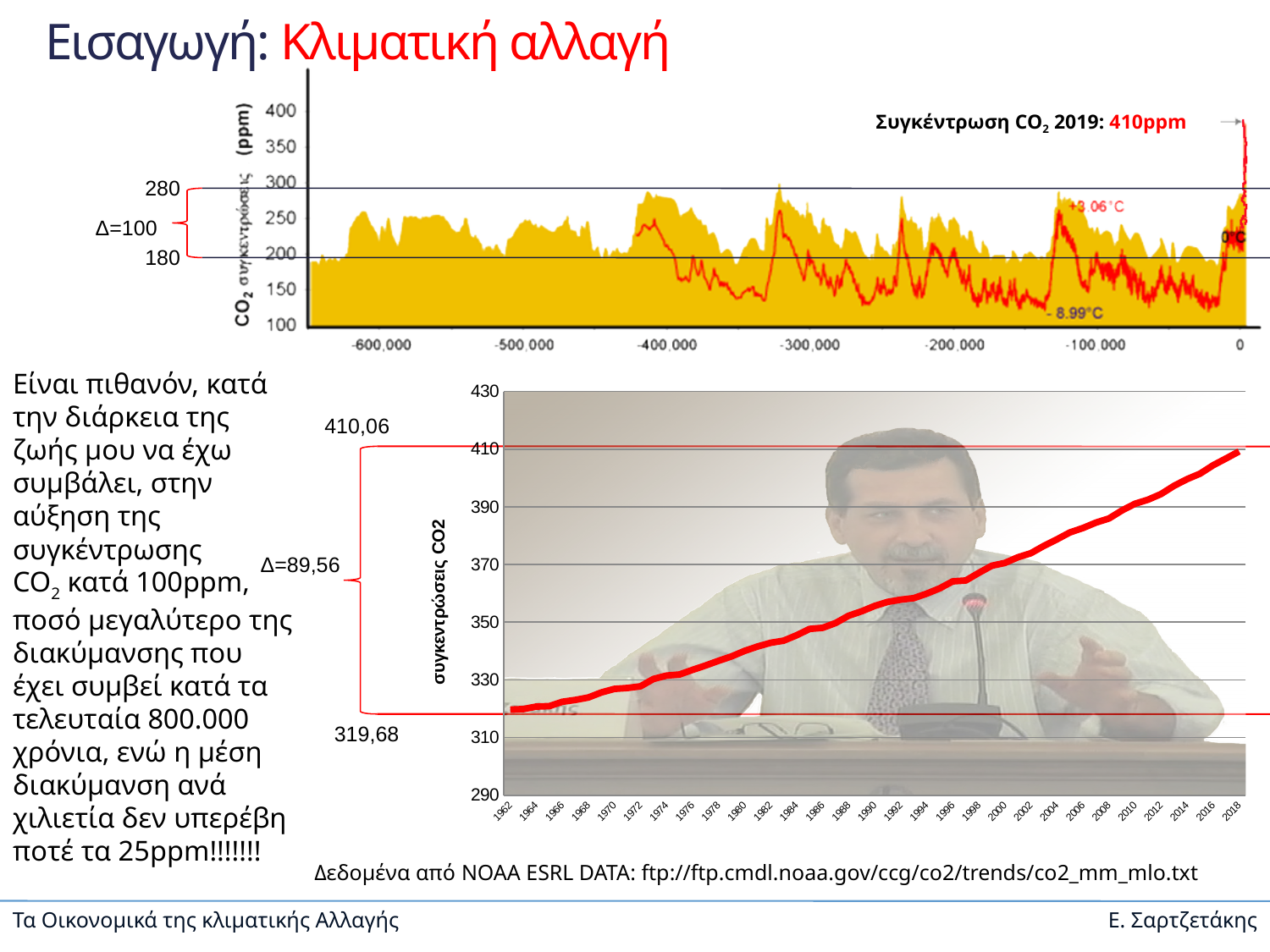
In the bottom chart (1962–2018), what CO2 concentration value is annotated at the end of the series (2018)? 410,06 In the top chart (CO2 over the last 800,000 years), what is the highest value shown on the y-axis? 400 What kind of chart is the bottom chart (συγκεντρώσεις CO2, 1962–2018)? line chart What is the y-axis label of the bottom chart (1962–2018)? συγκεντρώσεις CO2 In the top chart (CO2 over the last 800,000 years), what is the difference (Δ) between the two annotated levels 280 and 180? 100 In the bottom chart (1962–2018), do the CO2 concentrations rise or fall over time? rise In the bottom chart (1962–2018), is the value for 2014 greater or less than 390? greater In the bottom chart (1962–2018), is the value for 1970 greater or less than 330? less In the bottom chart (1962–2018), which year has the higher CO2 concentration, 1980 or 2000? 2000 In the bottom chart (1962–2018), what CO2 concentration value is annotated at the start of the series (1962)? 319,68 In the top chart (CO2 over the last 800,000 years), what CO2 concentration for 2019 is stated in the annotation? 410ppm